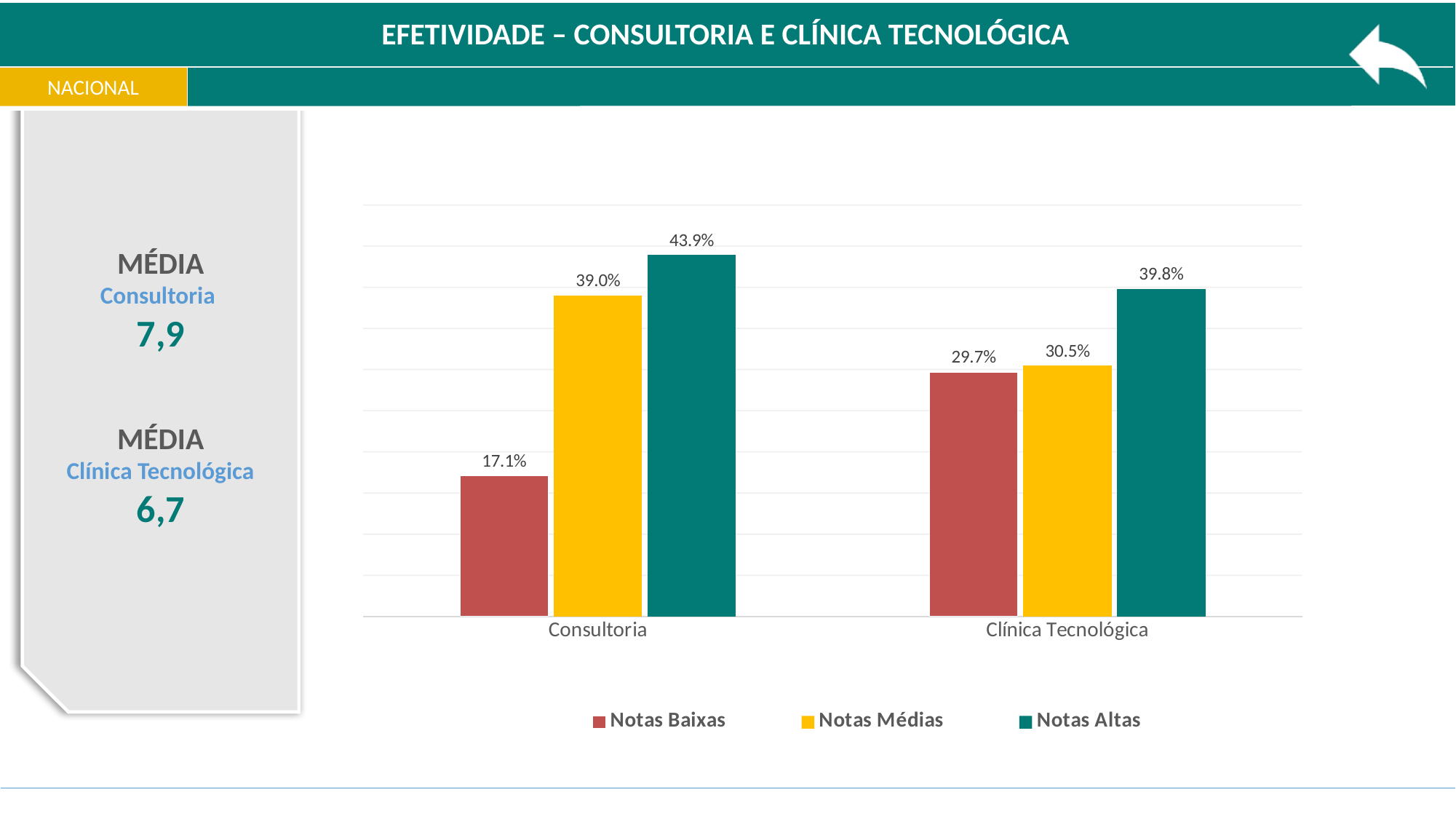
What is the value for Notas Altas in the Clínica Tecnológica category? 39.8% What is the value for Notas Baixas in the Consultoria category? 17.1% What is the value for Notas Médias in the Consultoria category? 39.0% What is the difference between Notas Altas and Notas Baixas in the Consultoria category? 26.8% What is the value for Notas Médias in the Clínica Tecnológica category? 30.5% Which is larger: Notas Altas for Consultoria or Notas Altas for Clínica Tecnológica? Notas Altas for Consultoria How many categories are shown on the x axis? 2 How many series does the legend list? 3 Which series has the highest value in the Consultoria category? Notas Altas What kind of chart is shown on the slide? Bar chart Which series has the lowest value in the Clínica Tecnológica category? Notas Baixas What is the difference between Notas Baixas for Clínica Tecnológica and Notas Baixas for Consultoria? 12.6%